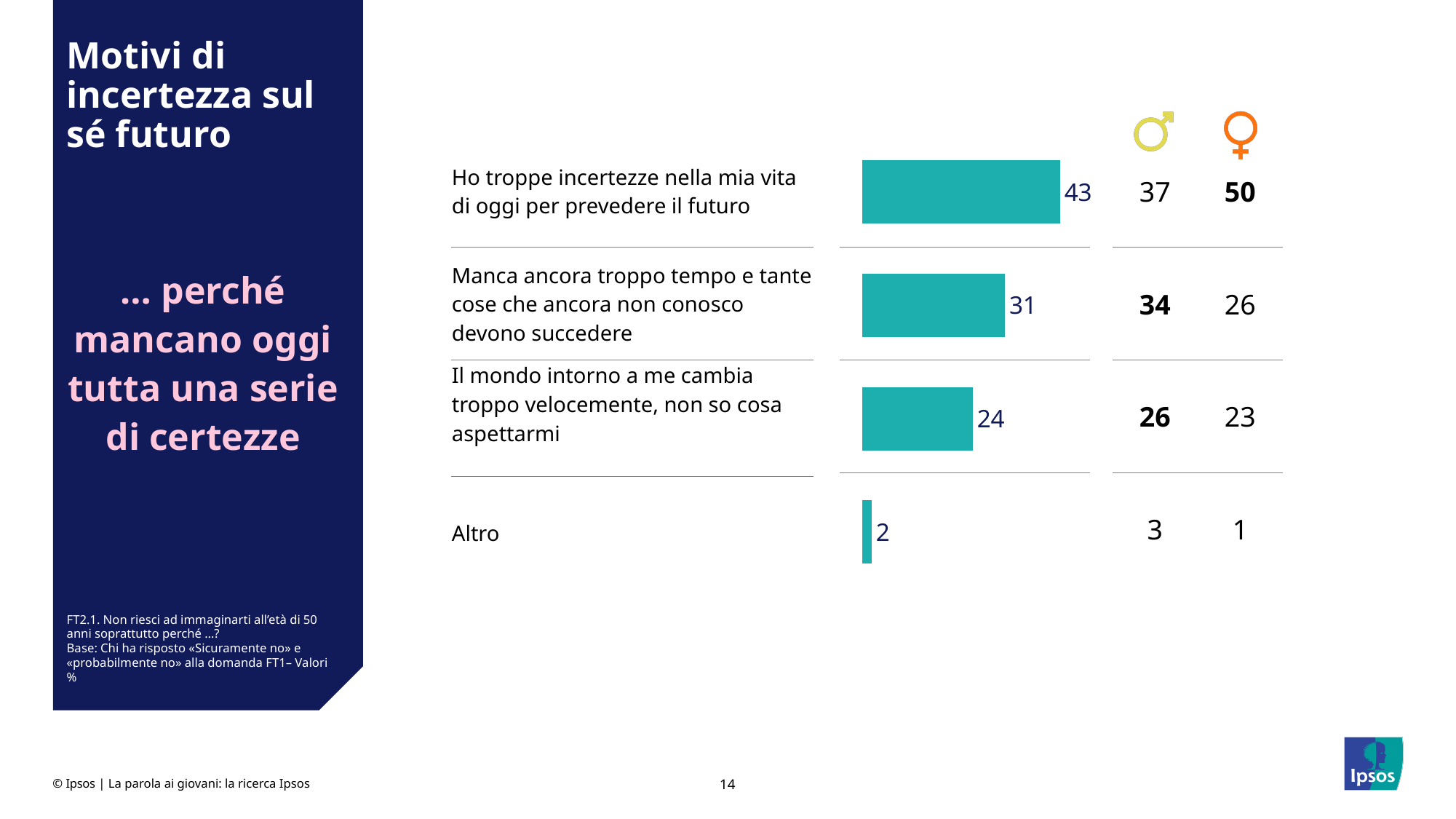
What is the value for "Altro"? 2 What is the difference between the female and male values for "Ho troppe incertezze nella mia vita di oggi per prevedere il futuro"? 13 Which is larger: the value for "Manca ancora troppo tempo e tante cose che ancora non conosco devono succedere" or for "Il mondo intorno a me cambia troppo velocemente, non so cosa aspettarmi"? Manca ancora troppo tempo e tante cose che ancora non conosco devono succedere What is the value for females (female symbol column) for "Ho troppe incertezze nella mia vita di oggi per prevedere il futuro"? 50 Which category has the highest value? Ho troppe incertezze nella mia vita di oggi per prevedere il futuro What is the value for males (male symbol column) for "Manca ancora troppo tempo e tante cose che ancora non conosco devono succedere"? 34 What is the value for "Ho troppe incertezze nella mia vita di oggi per prevedere il futuro"? 43 What is the value for "Il mondo intorno a me cambia troppo velocemente, non so cosa aspettarmi"? 24 Which category has the lowest value? Altro How many categories are shown in the bar chart? 4 What is the difference between the values for "Ho troppe incertezze nella mia vita di oggi per prevedere il futuro" and "Manca ancora troppo tempo e tante cose che ancora non conosco devono succedere"? 12 What kind of chart is shown on the slide? Bar chart